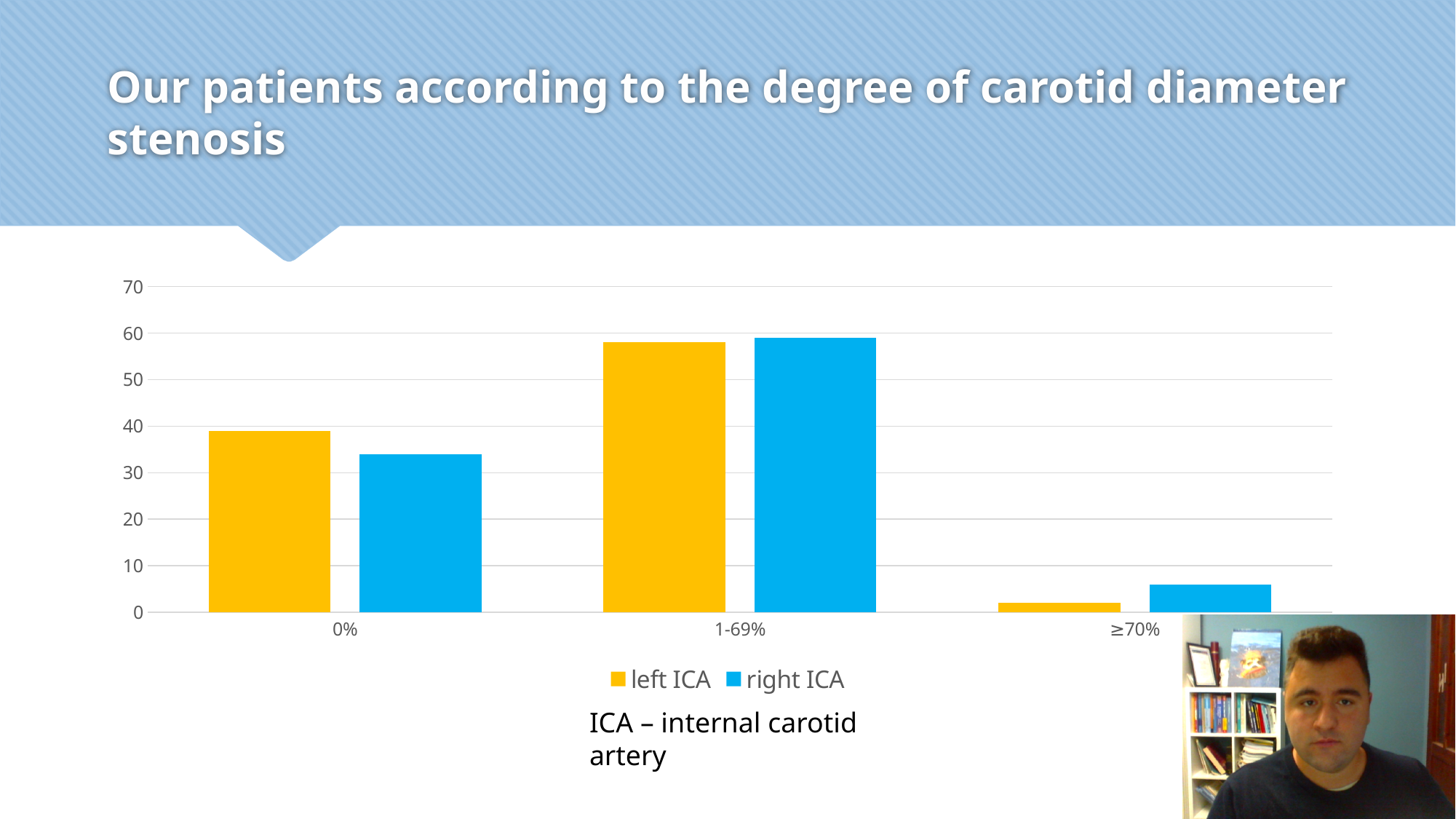
How many stenosis categories are shown on the x axis? 3 Which stenosis category has the lowest value for left ICA? ≥70% In the ≥70% category, which is larger: left ICA or right ICA? right ICA Which stenosis category has the lowest value for right ICA? ≥70% What colour are the bars for right ICA? blue Is the value for left ICA in the 0% category greater or less than 30? greater Is the value for right ICA in the 0% category greater or less than 40? less In the 0% category, which is larger: left ICA or right ICA? left ICA Which stenosis category has the highest value for left ICA? 1-69% How many series does the legend list? 2 What kind of chart is shown on the slide? bar chart Is the value for left ICA in the 1-69% category greater or less than 50? greater